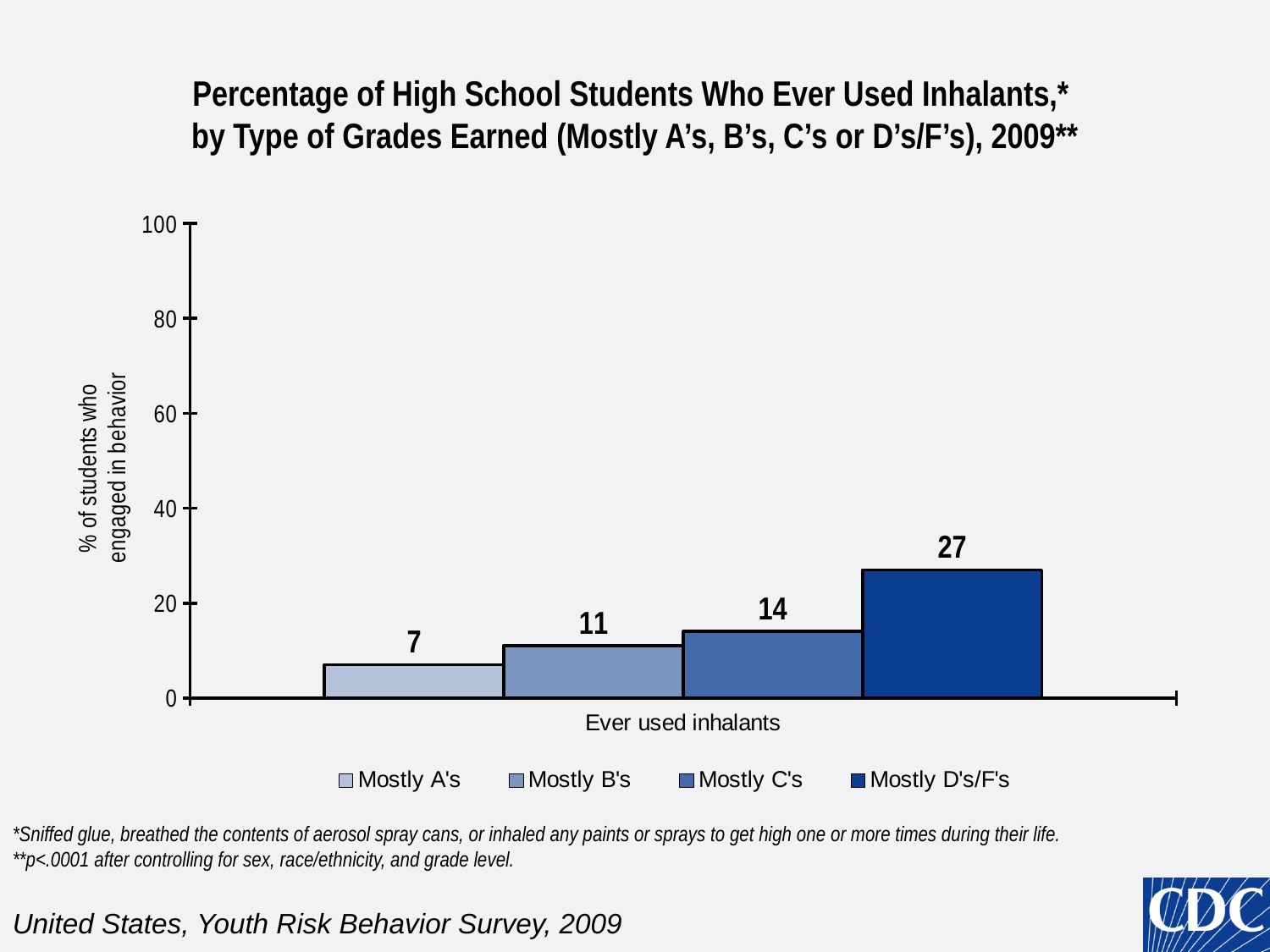
What is the value for Mostly C's? 14 Which grade group has the highest percentage of students who ever used inhalants? Mostly D's/F's Which grade group has the lowest percentage of students who ever used inhalants? Mostly A's What kind of chart is shown on the slide? Bar chart What is the label on the y axis? % of students who engaged in behavior What is the value for Mostly D's/F's? 27 What is the value for Mostly B's? 11 Which is larger, the value for Mostly B's or Mostly C's? Mostly C's Is the value for Mostly D's/F's greater or less than 20? greater How many series does the legend list? 4 What is the difference between the values for Mostly D's/F's and Mostly A's? 20 What percentage of students with Mostly A's ever used inhalants? 7